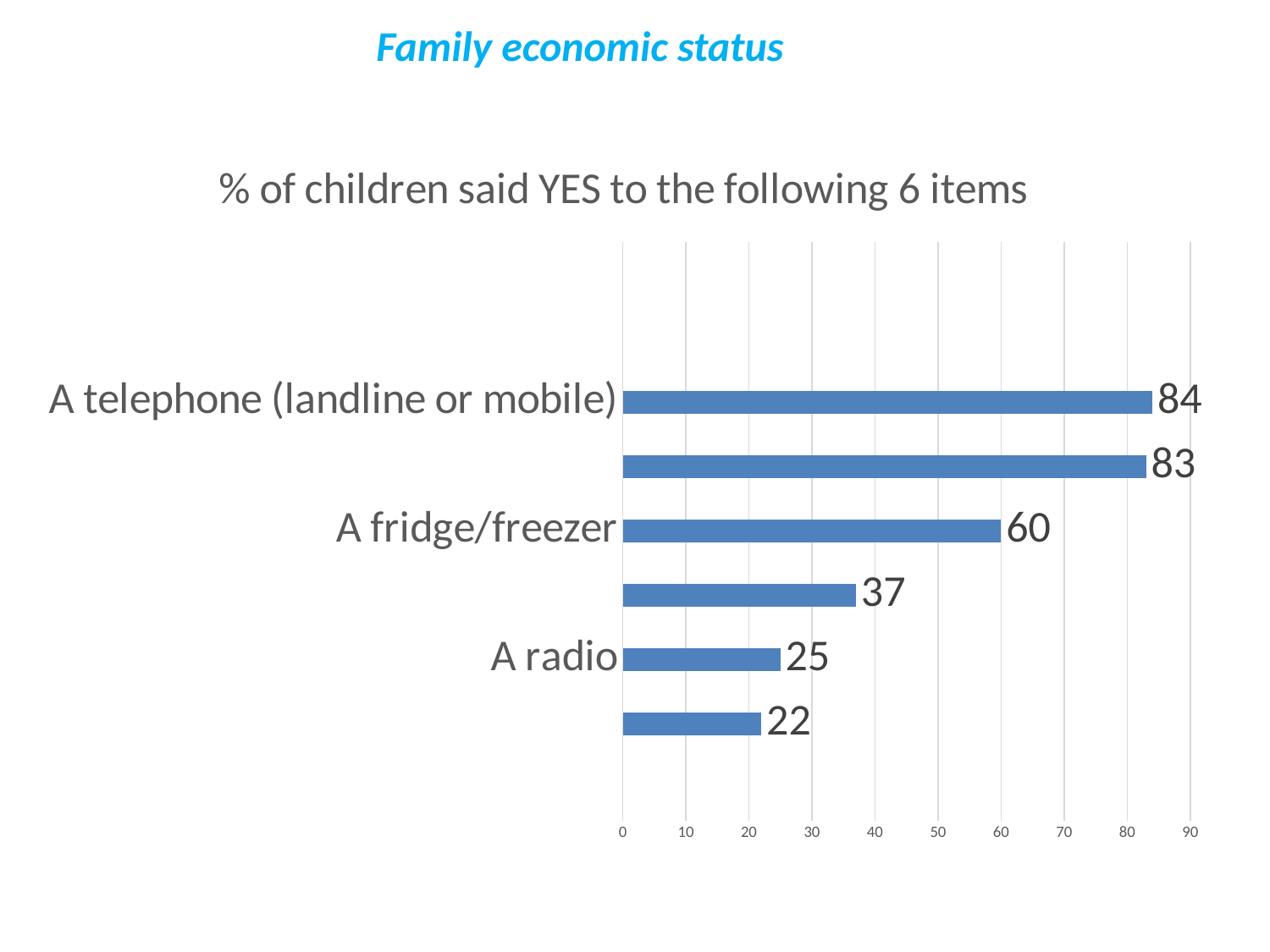
What is the value for 'A fridge/freezer'? 60 Which is larger, the value for 'A fridge/freezer' or the value for 'A radio'? A fridge/freezer What is the difference between the values for 'A telephone (landline or mobile)' and 'A fridge/freezer'? 24 How many bars are plotted on the chart? 6 What is the value for 'A radio'? 25 What is the lowest value shown on the chart? 22 Is the value for 'A radio' greater or less than 30? less What percentage of children said YES to having a telephone (landline or mobile)? 84 What is the title of the chart? % of children said YES to the following 6 items What is the difference between the values for 'A fridge/freezer' and 'A radio'? 35 What kind of chart is shown on the slide? bar chart Which item has the highest percentage of children saying YES? A telephone (landline or mobile)